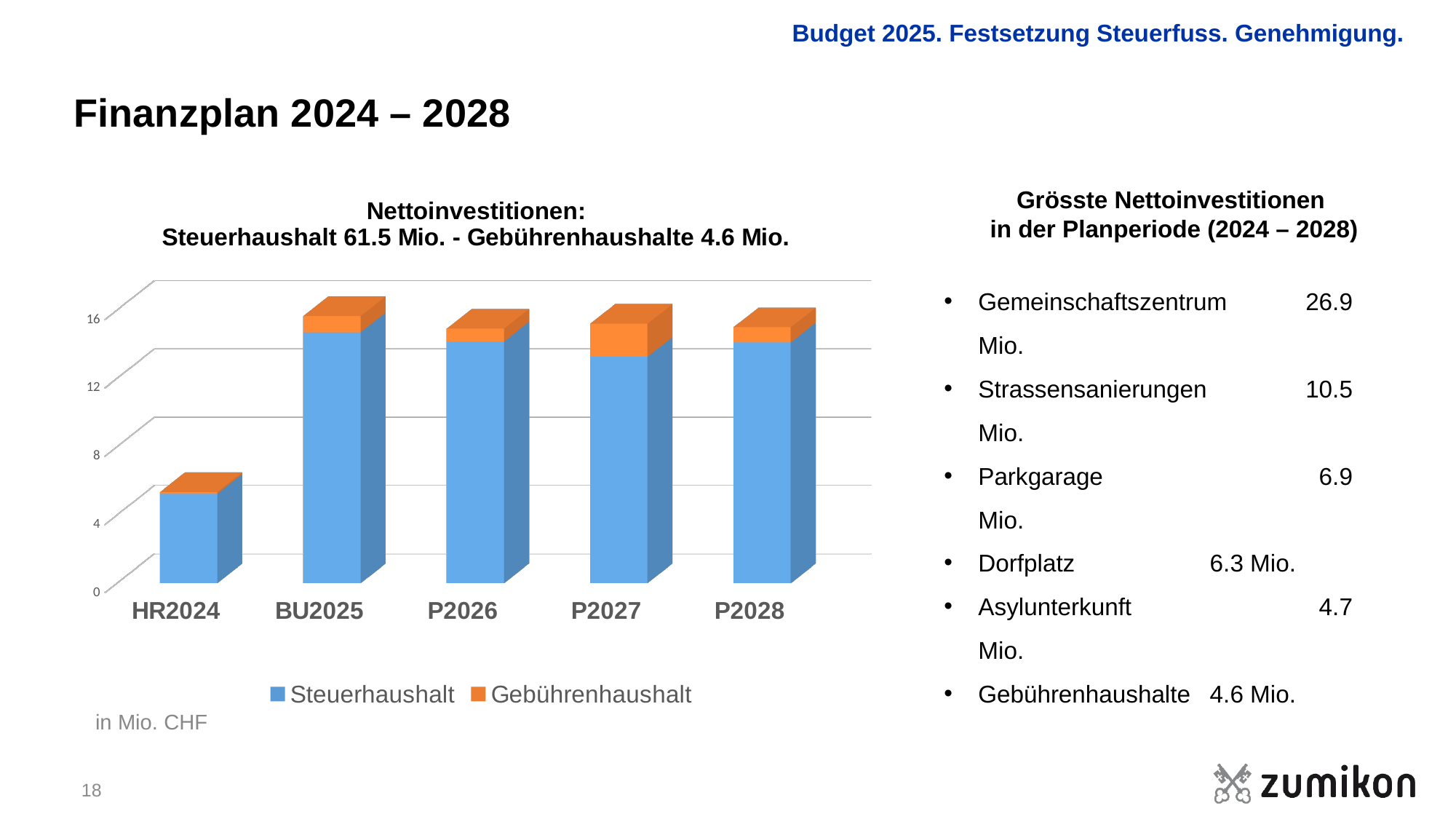
Which category has the lowest total net investment in the chart? HR2024 Is the total value for HR2024 greater or less than 8? less Is the Steuerhaushalt value for HR2024 greater or less than 4? greater How many categories are shown on the x axis of the chart? 5 Is the Steuerhaushalt value for P2027 greater or less than 8? greater Which series is shown in orange in the chart? Gebührenhaushalt How many series does the chart legend list? 2 In P2027, which series has the larger value, Steuerhaushalt or Gebührenhaushalt? Steuerhaushalt What kind of chart is shown on the slide? bar chart What unit is stated for the values in the chart? in Mio. CHF Which has the larger total value, HR2024 or BU2025? BU2025